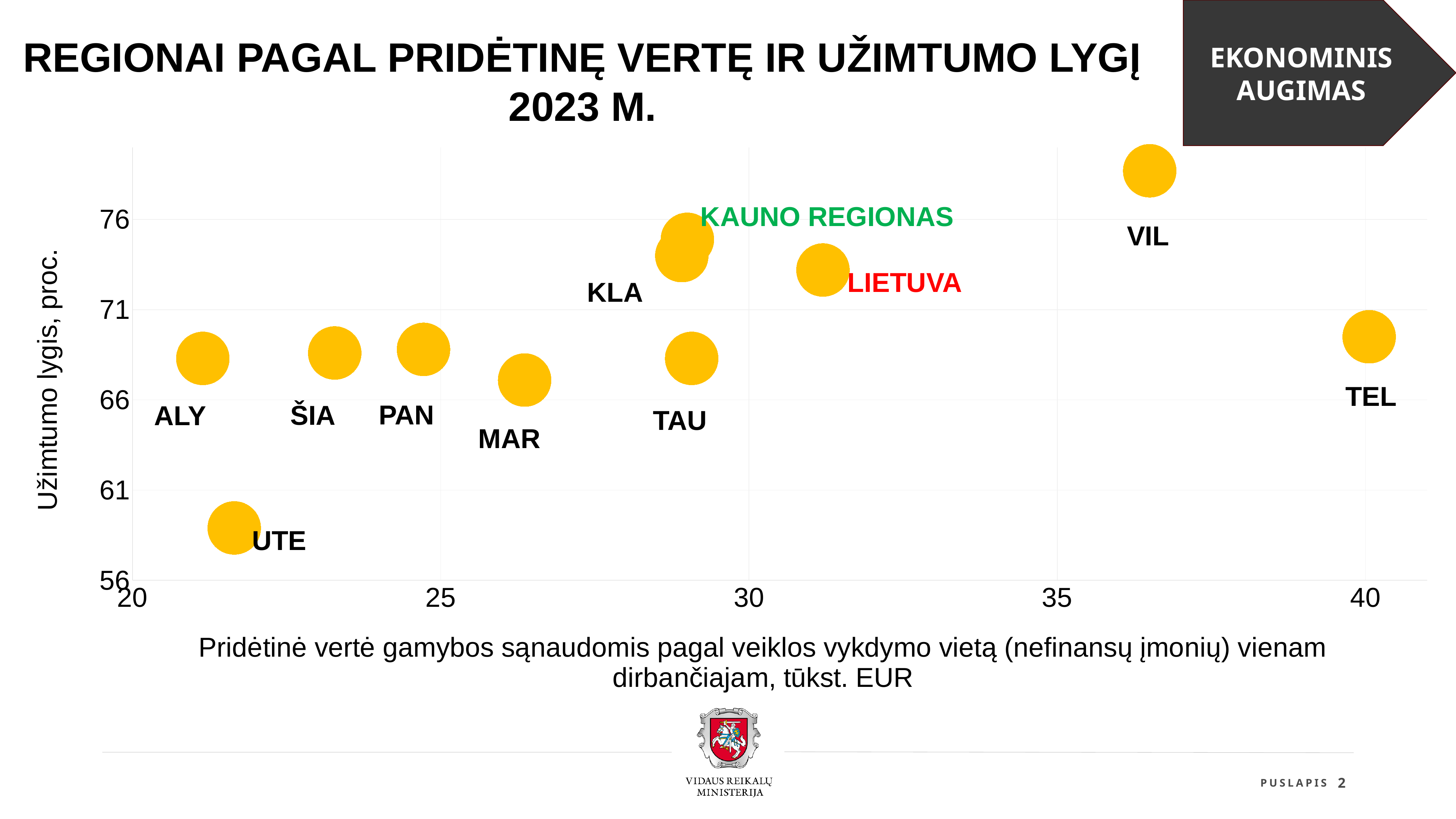
Is the employment level for KLA greater or less than 71? greater Which region has the lowest value added per employee (x axis)? ALY What kind of chart is shown on the slide? scatter chart Is the employment level for VIL greater or less than 76? greater Is the employment level for UTE greater or less than 61? less Which region has the highest employment level (Užimtumo lygis)? VIL Which region has the highest value added per employee (x axis)? TEL How many labelled points are plotted on the chart? 11 Which region has the lowest employment level (Užimtumo lygis)? UTE What is the title of the chart? REGIONAI PAGAL PRIDĖTINĘ VERTĘ IR UŽIMTUMO LYGĮ 2023 M. Which has a higher employment level, VIL or TEL? VIL